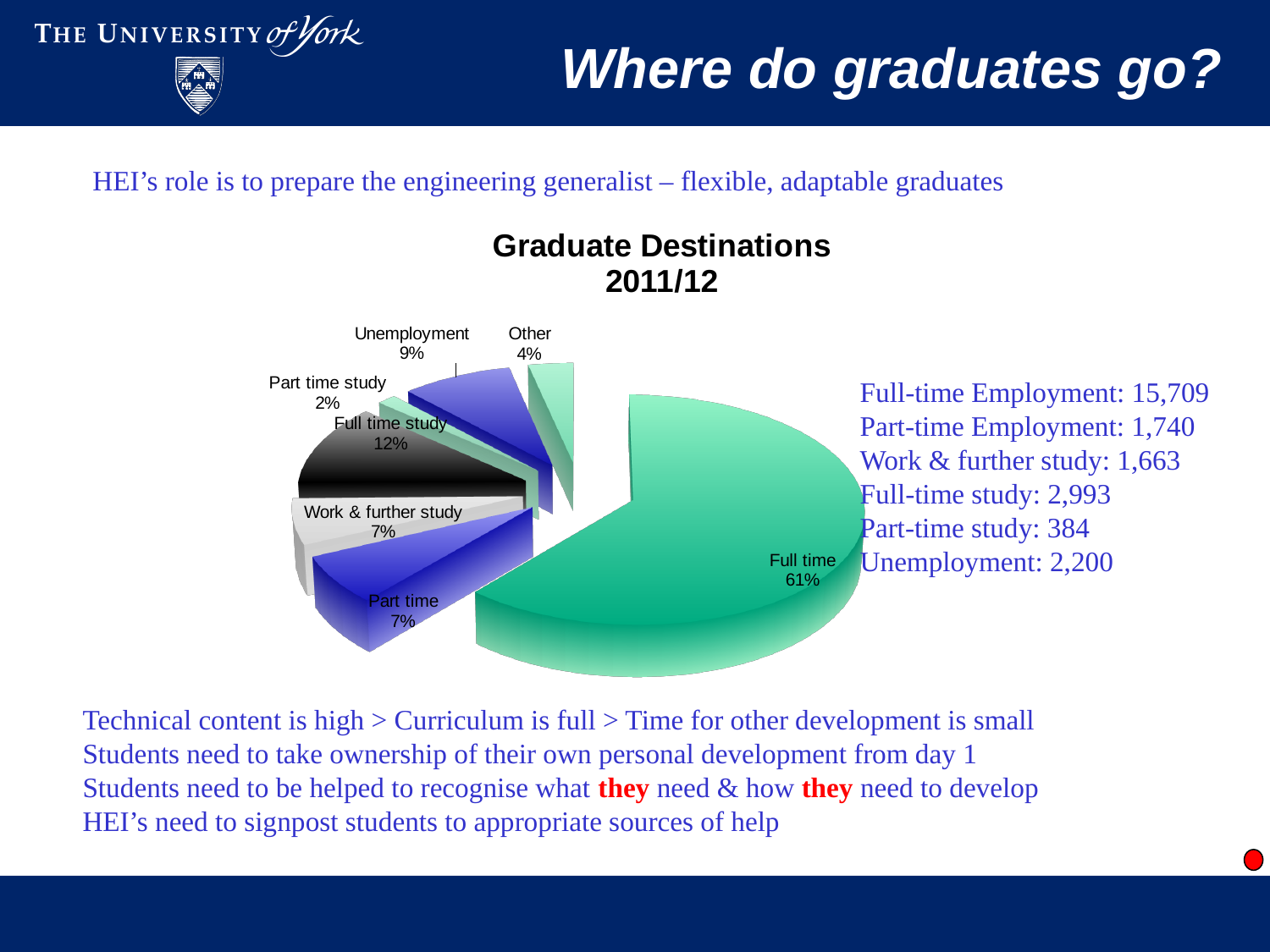
What percentage is shown for Other in the pie chart? 4% Which is larger in the pie chart, Unemployment or Other? Unemployment What percentage of graduates are in full time employment according to the pie chart? 61% What is the difference in percentage points between Full time study and Part time study? 10% What percentage is shown for Unemployment in the pie chart? 9% How many slices does the pie chart have? 7 What share of the pie does Full time study represent? 12% What is the title of the chart? Graduate Destinations 2011/12 Which category has the smallest slice of the pie chart? Part time study What type of chart is shown on the slide? pie chart Which category has the largest slice of the pie chart? Full time What is the difference in percentage points between Full time and Unemployment? 52%